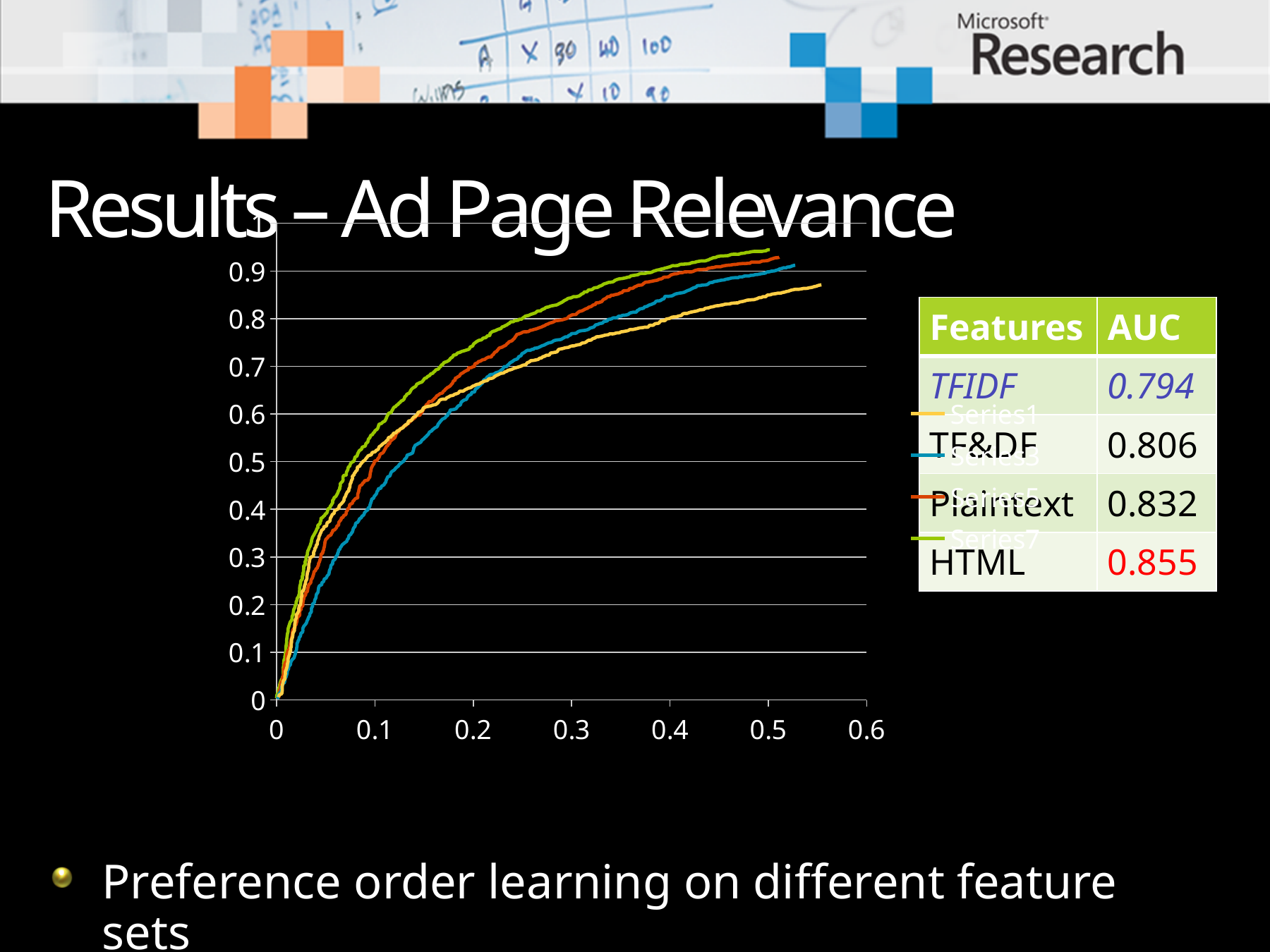
What kind of chart is shown on the slide? line chart What colour is the line for Series7 in the legend? green What is the highest tick label shown on the x axis? 0.6 Which series has the highest value at x = 0.4? Series7 Which series has the lowest value at x = 0.4? Series1 Is the value of Series7 at x = 0.5 greater or less than 0.9? greater Which series has the lowest value at x = 0.1? Series3 How many series does the chart legend list? 4 At x = 0.3, which is larger: Series7 or Series1? Series7 Do the plotted lines rise or fall as the x-axis value increases? rise Is the value of Series1 at x = 0.5 greater or less than 0.9? less